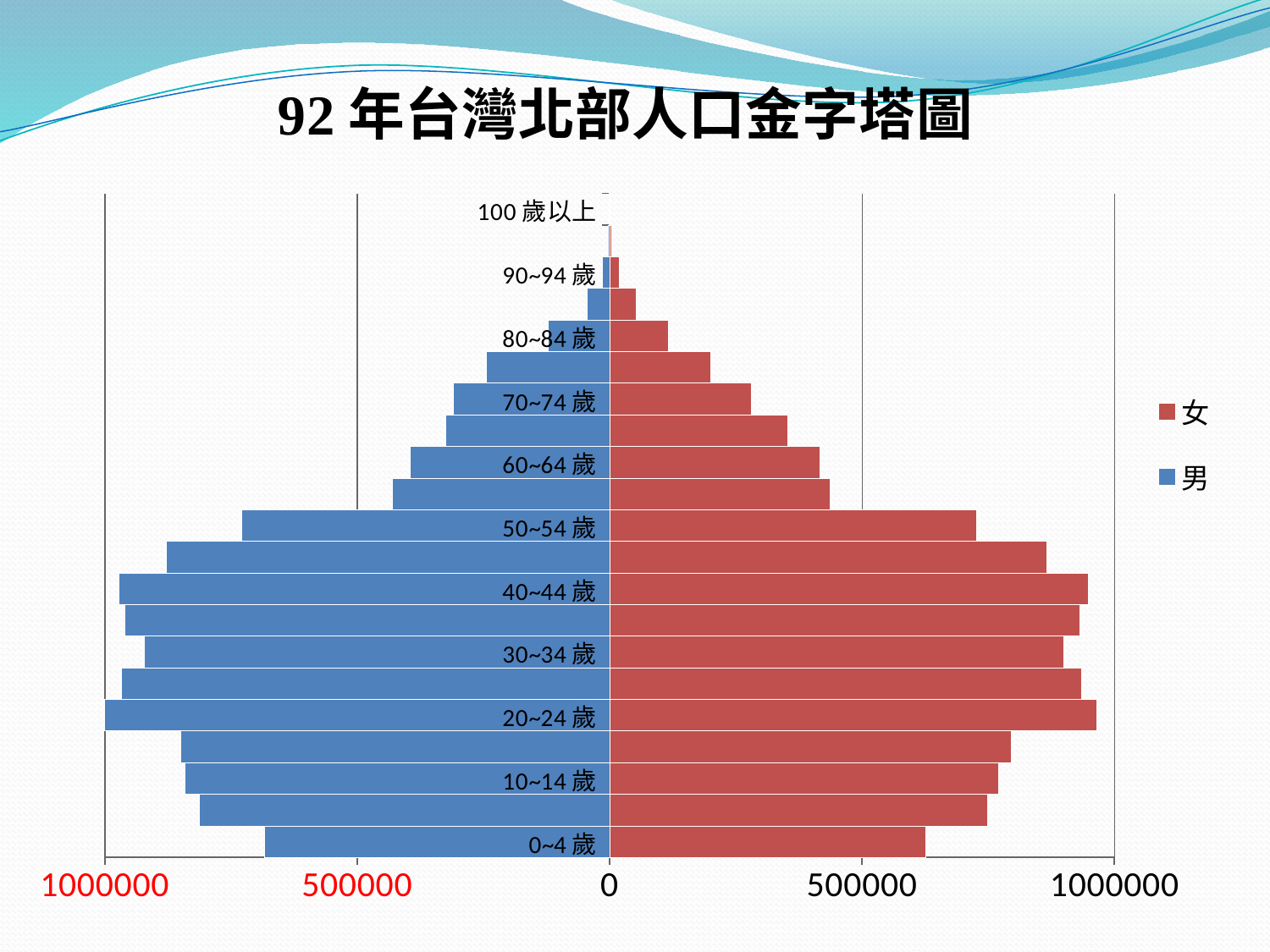
Is the 女 value for 0~4 歲 greater or less than 500000? greater What kind of chart is shown on the slide? bar chart Is the 女 value for 80~84 歲 greater or less than 500000? less What are the two series named in the legend? 女 and 男 What colour are the bars for the 男 series? blue How many series does the legend list? 2 Do the 女 values rise or fall going from 40~44 歲 up to 100 歲以上? fall Is the 女 value for 60~64 歲 greater or less than 500000? less For 0~4 歲, which is larger, the 男 value or the 女 value? 男 Which age group has the lowest 男 value? 100 歲以上 For the 女 series, which is larger, the value for 50~54 歲 or the value for 0~4 歲? 50~54 歲